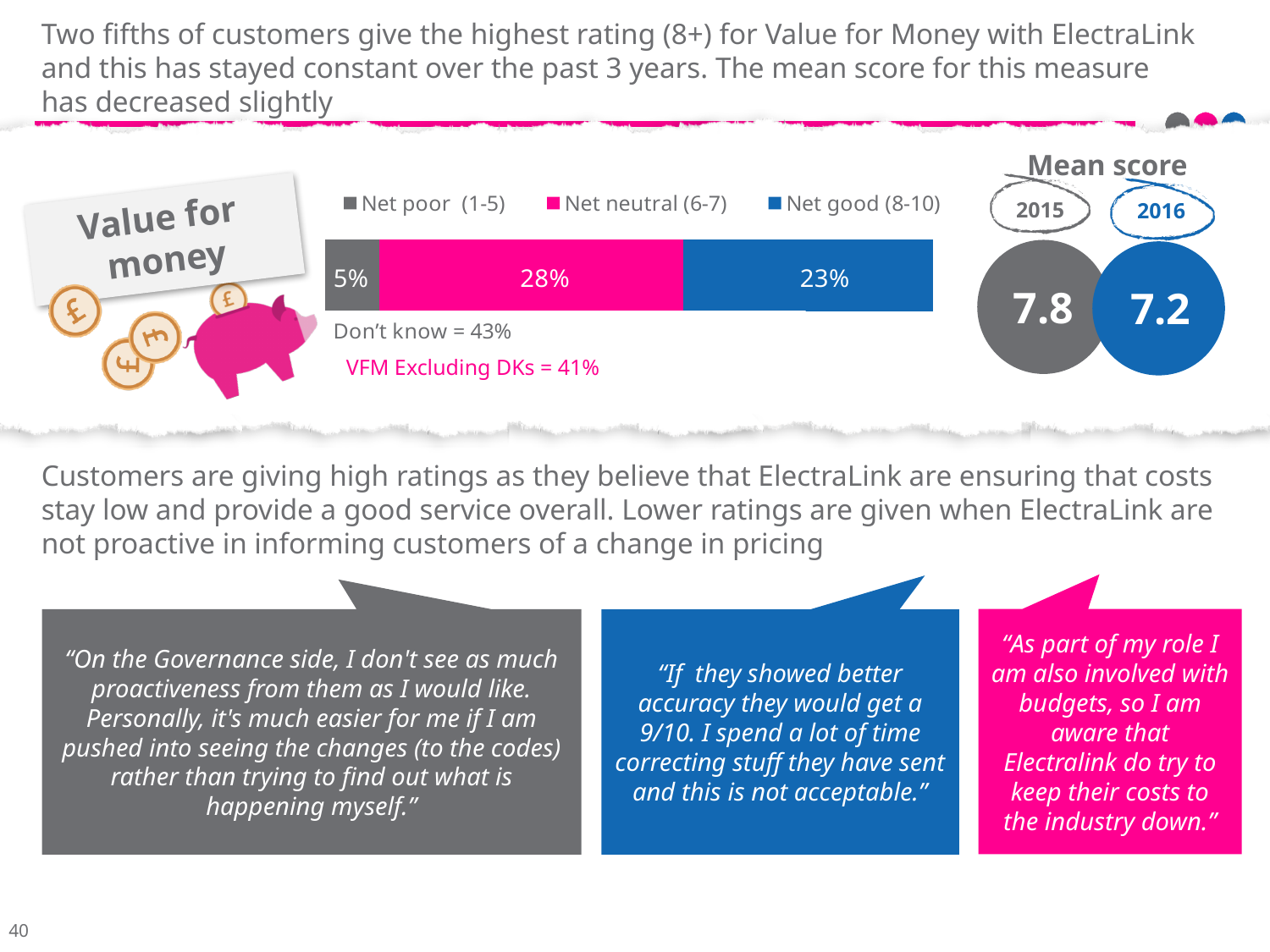
Which rating category has the lowest percentage in the Value for money bar? Net poor (1-5) What percentage of customers gave a Net neutral (6-7) rating for Value for money? 28% Which colour represents Net neutral (6-7) in the Value for money chart? Pink Which is larger, the Net good (8-10) percentage or the Net poor (1-5) percentage? Net good (8-10) What is the difference in percentage points between the Net neutral (6-7) and Net poor (1-5) segments? 23 What percentage of customers gave a Net good (8-10) rating for Value for money? 23% What is the total of the three labelled segments in the Value for money stacked bar? 56% What percentage of customers gave a Net poor (1-5) rating for Value for money? 5% What is the difference in percentage points between the Net neutral (6-7) and Net good (8-10) segments? 5 What kind of chart is used to show the Value for money ratings? Stacked bar chart Which rating category has the highest percentage in the Value for money bar? Net neutral (6-7) How many series does the legend of the Value for money chart list? 3